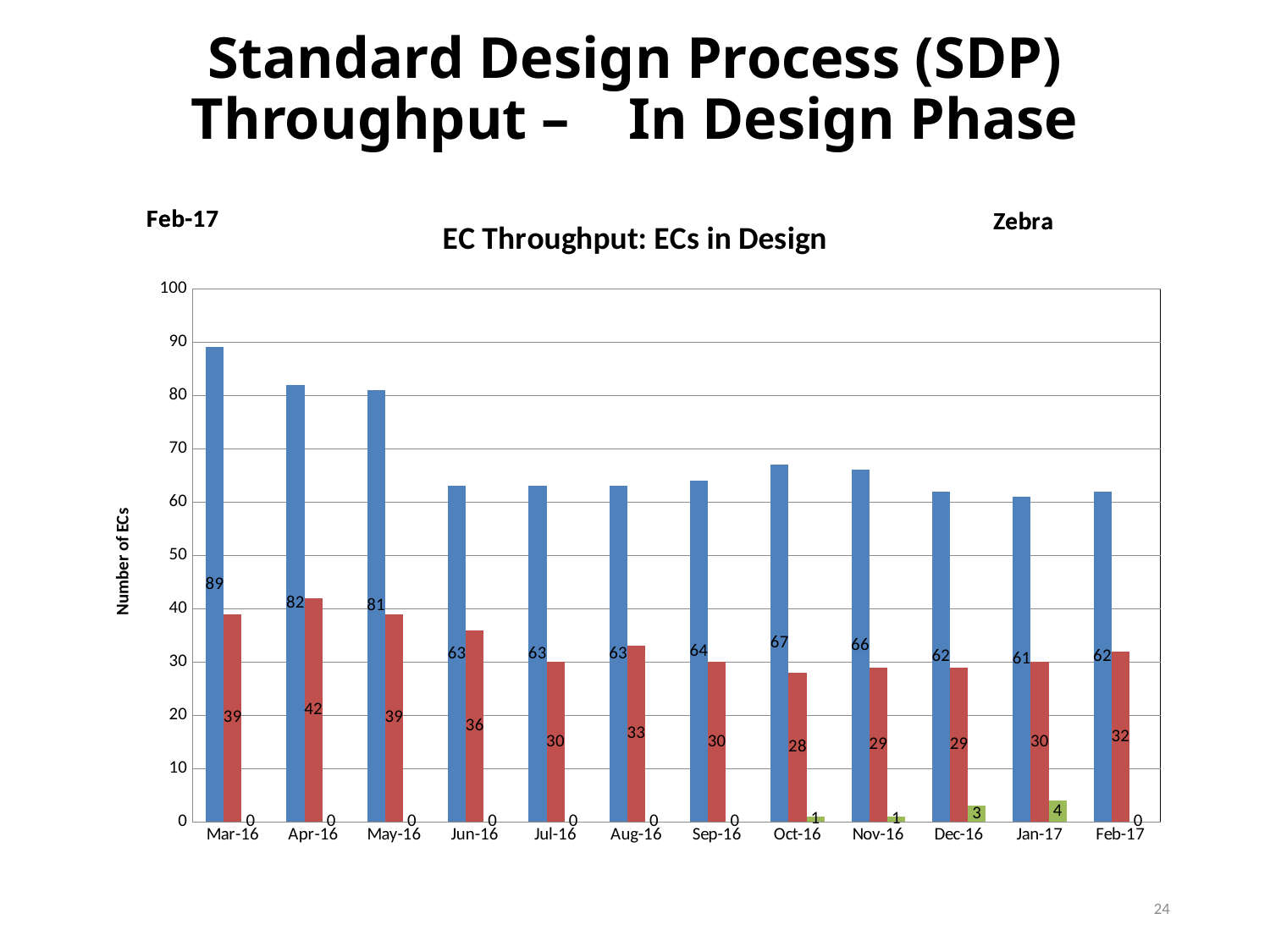
How many months are shown on the x axis? 12 Which month has the highest blue bar? Mar-16 What is the value of the red bar for Apr-16? 42 What is the difference between the blue bar and the red bar for Feb-17? 30 What is the title of the chart? EC Throughput: ECs in Design What kind of chart is shown? bar chart Which is larger, the blue bar for Oct-16 or the blue bar for Dec-16? Oct-16 What is the value of the blue bar for Mar-16? 89 What is the value of the green bar for Jan-17? 4 Do the blue bars generally rise or fall from Mar-16 to Feb-17? fall Which month has the lowest red bar? Oct-16 Is the blue bar for May-16 greater or less than 70? greater